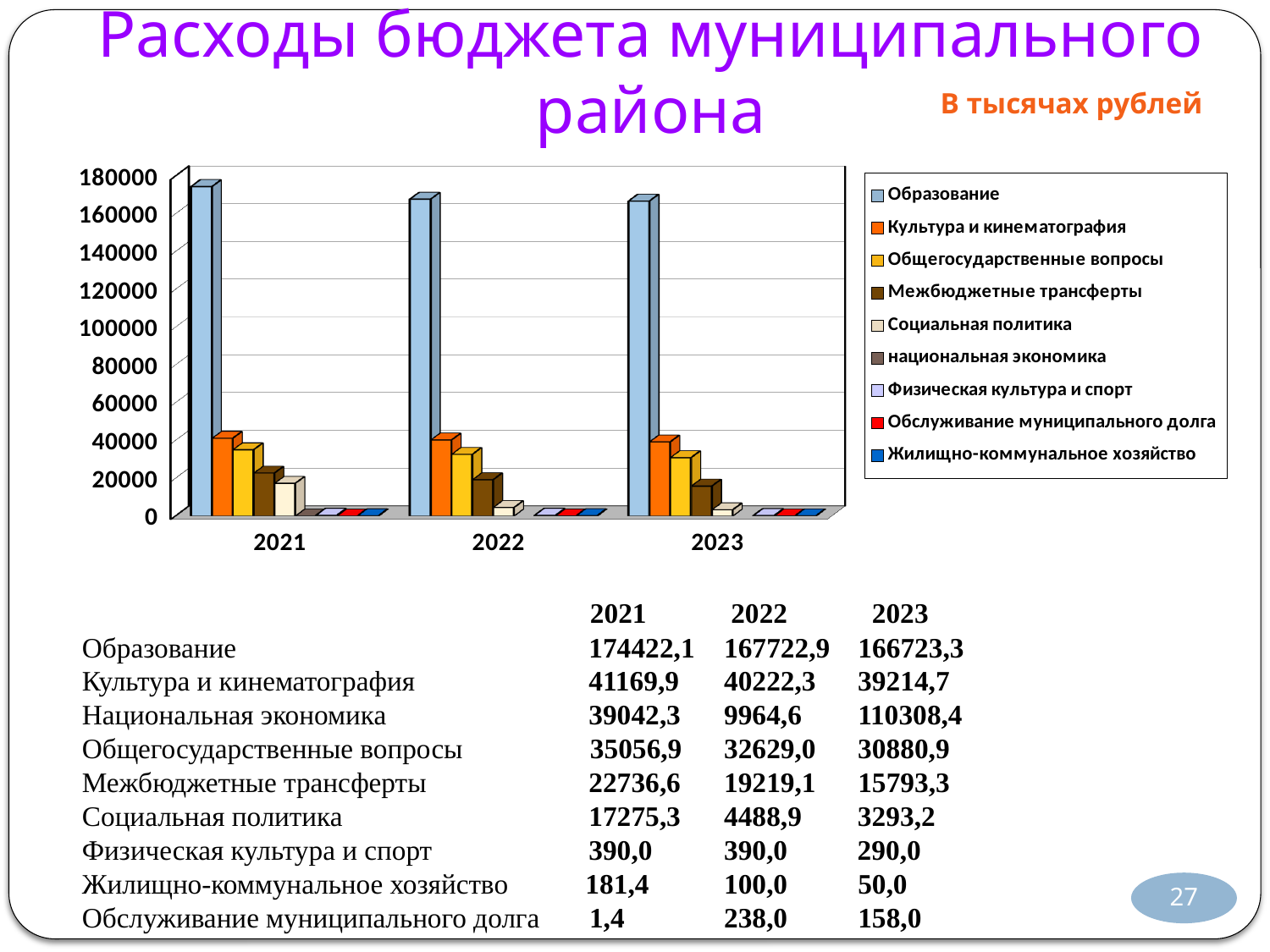
In which year is the value for Социальная политика the lowest? 2023 What is the value for Межбюджетные трансферты in 2022? 19219,1 In 2021, which is larger: Культура и кинематография or Общегосударственные вопросы? Культура и кинематография How many years are shown along the x axis of the chart? 3 Is the value for Образование in 2022 greater or less than 160000? greater What is the value for Образование in 2021? 174422,1 What is the value for Культура и кинематография in 2023? 39214,7 What kind of chart is shown on the slide? bar chart Does the value for Образование rise or fall from 2021 to 2023? falls How many series does the chart legend list? 9 In which year is the value for Образование the highest? 2021 What is the difference between the Образование values for 2021 and 2023? 7698,8